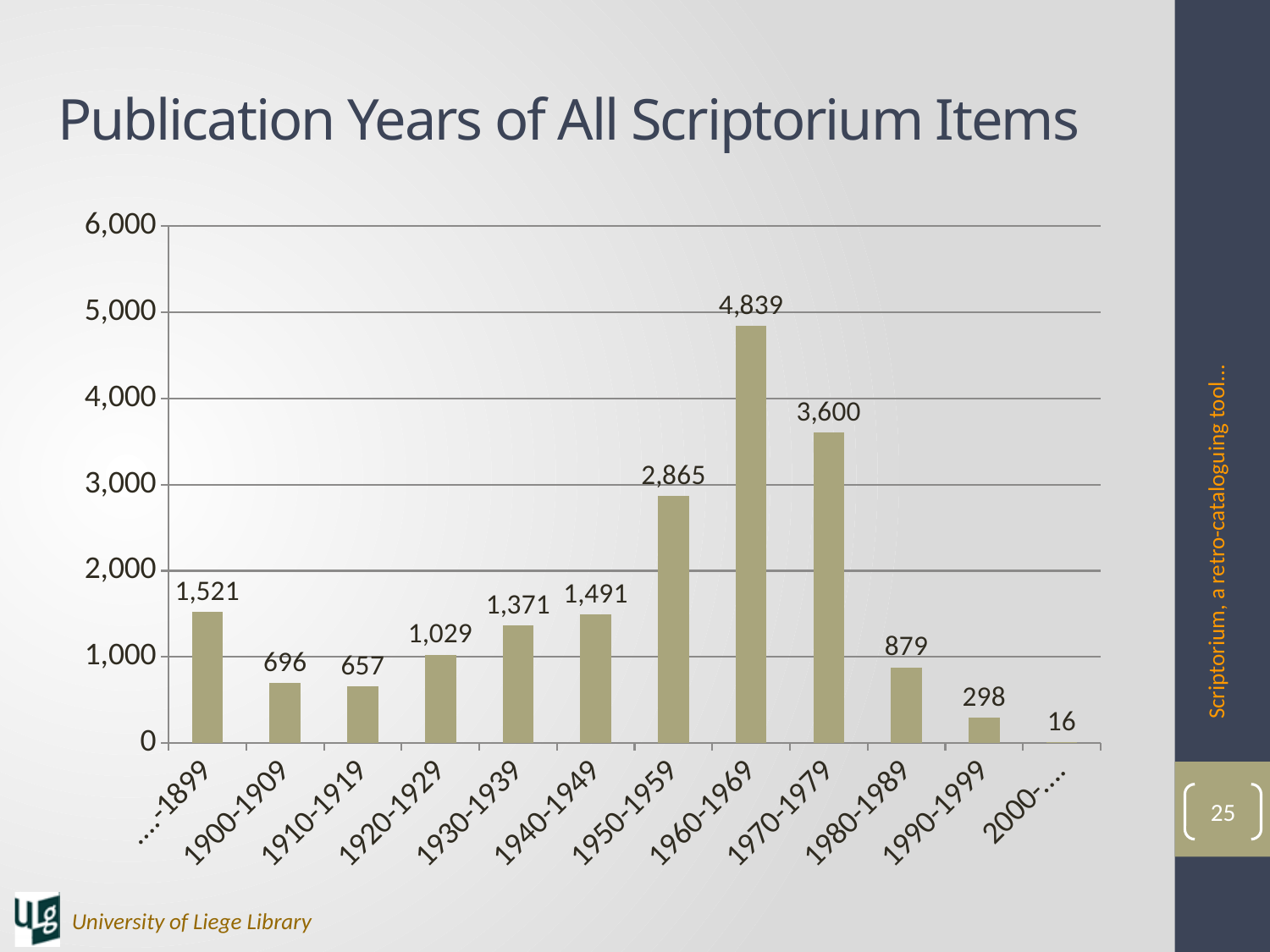
What is the difference between the values for 1960-1969 and 1970-1979? 1,239 Is the value for 1950-1959 greater or less than 3,000? less Which period has the highest value? 1960-1969 Which period has the lowest value? 2000-.... What is the title of the chart? Publication Years of All Scriptorium Items What is the value for 1920-1929? 1,029 What kind of chart is shown on the slide? bar chart What is the value for 1960-1969? 4,839 What is the value for 1990-1999? 298 Which is larger, the value for 1900-1909 or the value for 1910-1919? 1900-1909 Do the values rise or fall from 1910-1919 to 1960-1969? rise How many periods are shown on the x axis? 12